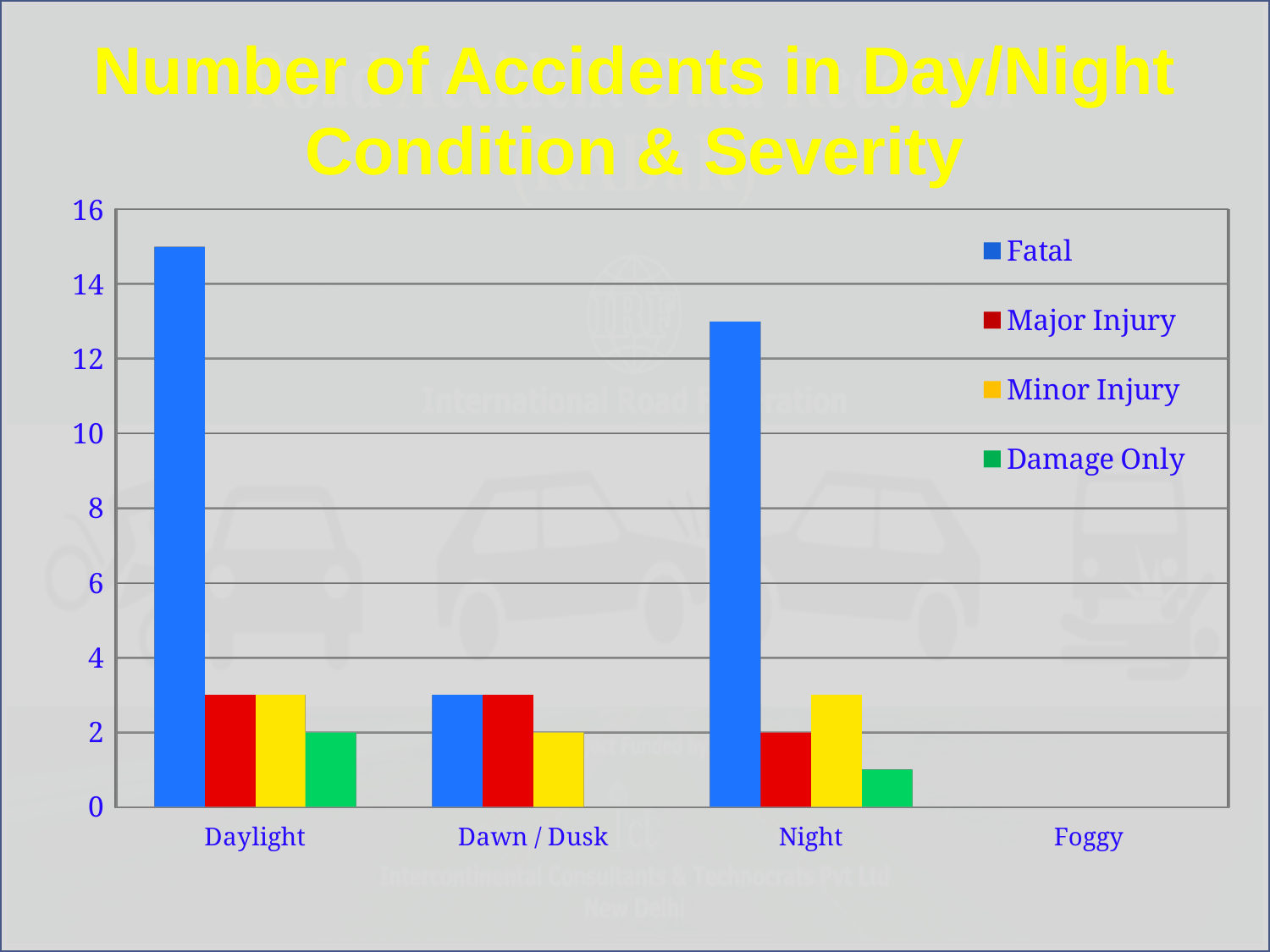
What is the value for Minor Injury in the Dawn / Dusk category? 2 How many series does the legend list? 4 How many categories are shown on the x axis? 4 Is the Fatal value for Night greater or less than 12? greater Which is larger, the Fatal value for Daylight or the Fatal value for Night? Daylight What kind of chart is shown on the slide? bar chart Is the Damage Only value for Night greater or less than 2? less Which series is shown in green in the legend? Damage Only What is the value for Major Injury in the Night category? 2 What is the value for Damage Only in the Daylight category? 2 Is the Fatal value for Daylight greater or less than 14? greater In which category is the Fatal value highest? Daylight